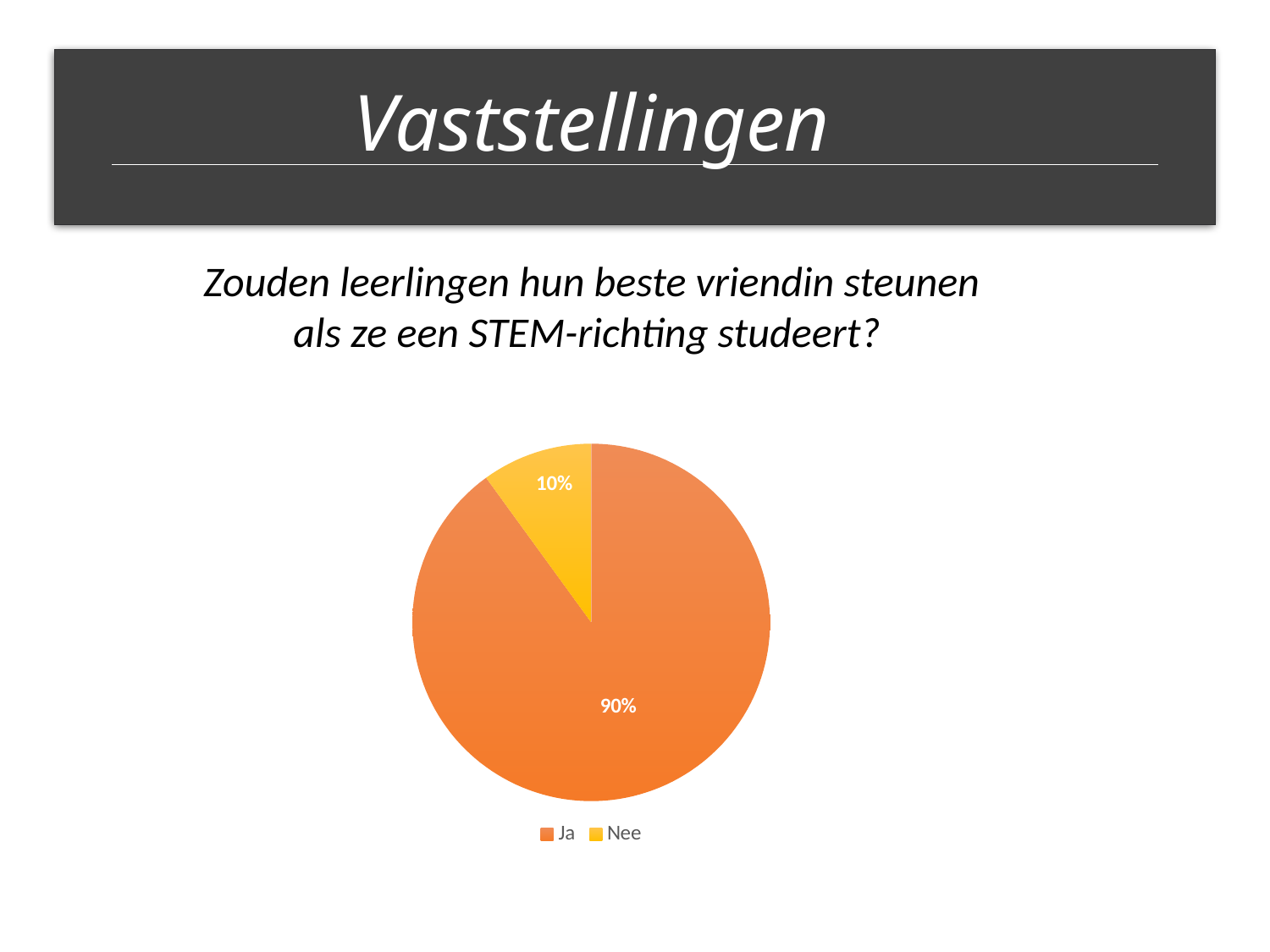
Which slice is the largest in the pie chart? Ja How many slices does the pie chart have? 2 What kind of chart is shown on the slide? pie chart What share of the pie does the "Ja" slice represent? 90% Which slice is the smallest in the pie chart? Nee How many entries does the legend list? 2 Which is larger, the "Ja" slice or the "Nee" slice? Ja What is the difference in percentage points between the "Ja" and "Nee" slices? 80 What question is the pie chart answering, according to the text above it? Zouden leerlingen hun beste vriendin steunen als ze een STEM-richting studeert? What colour is the "Nee" slice in the pie chart? yellow What share of the pie does the "Nee" slice represent? 10%